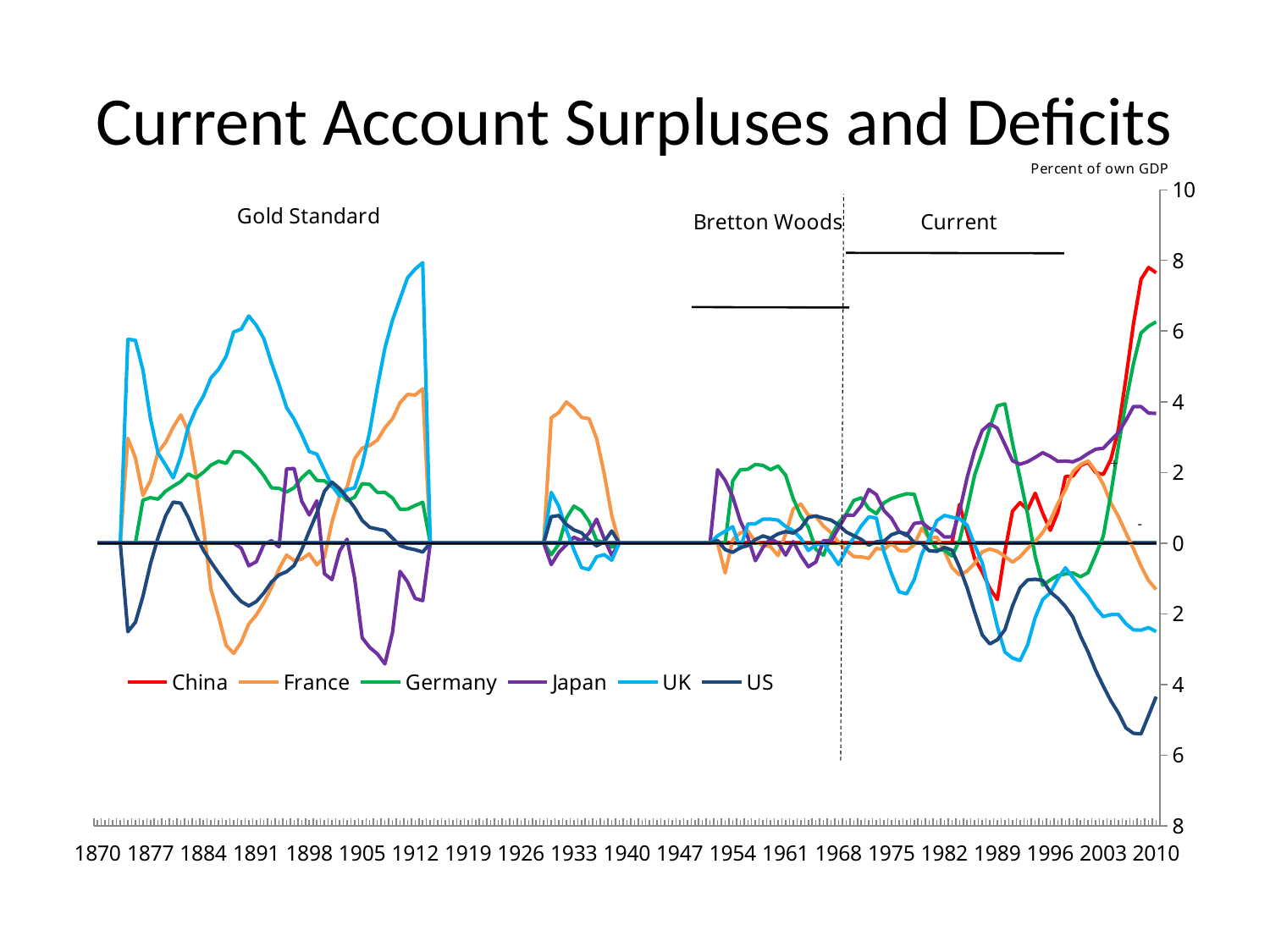
What unit label is shown above the vertical axis? Percent of own GDP At the right end of the chart (around 2010), which country has the highest value? China How many series does the legend list? 6 What kind of chart is shown on the slide? line chart Is the UK's peak value around 1913 greater or less than 6? greater Around 1913, which is higher, the value for the UK or the value for France? UK At the right end of the chart (around 2010), which country has the lowest value? US Around 2010, which is higher, the value for China or the value for Germany? China Does the US line rise or fall between about 1991 and 2006? fall Is the value for China at the right end of the chart (around 2010) greater or less than 6? greater Does the China line rise or fall between about 2000 and 2008? rise Which countries are listed in the legend? China, France, Germany, Japan, UK, US